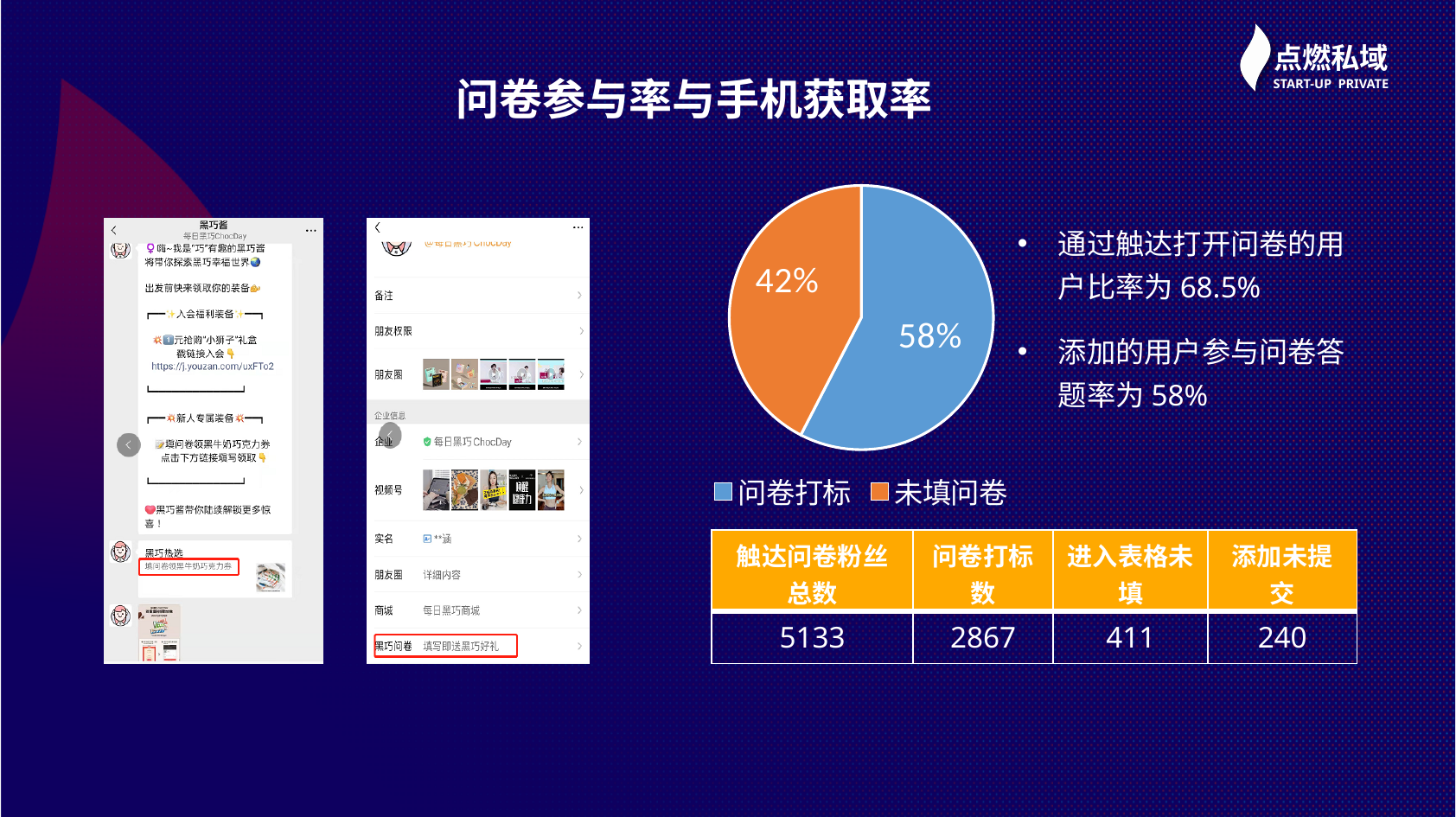
What share of the pie chart is labelled 未填问卷? 42% How many entries does the pie chart's legend list? 2 How many slices does the pie chart have? 2 Which slice of the pie chart is the smallest? 未填问卷 What share of the pie chart is labelled 问卷打标? 58% What kind of chart is shown on the slide? pie chart Which slice of the pie chart is the largest? 问卷打标 Is the share of the 未填问卷 slice greater or less than 50%? less What colour is the 未填问卷 slice in the pie chart? orange What is the difference in percentage points between the 问卷打标 slice and the 未填问卷 slice? 16 What colour is the 问卷打标 slice in the pie chart? blue Which is larger in the pie chart, 问卷打标 or 未填问卷? 问卷打标